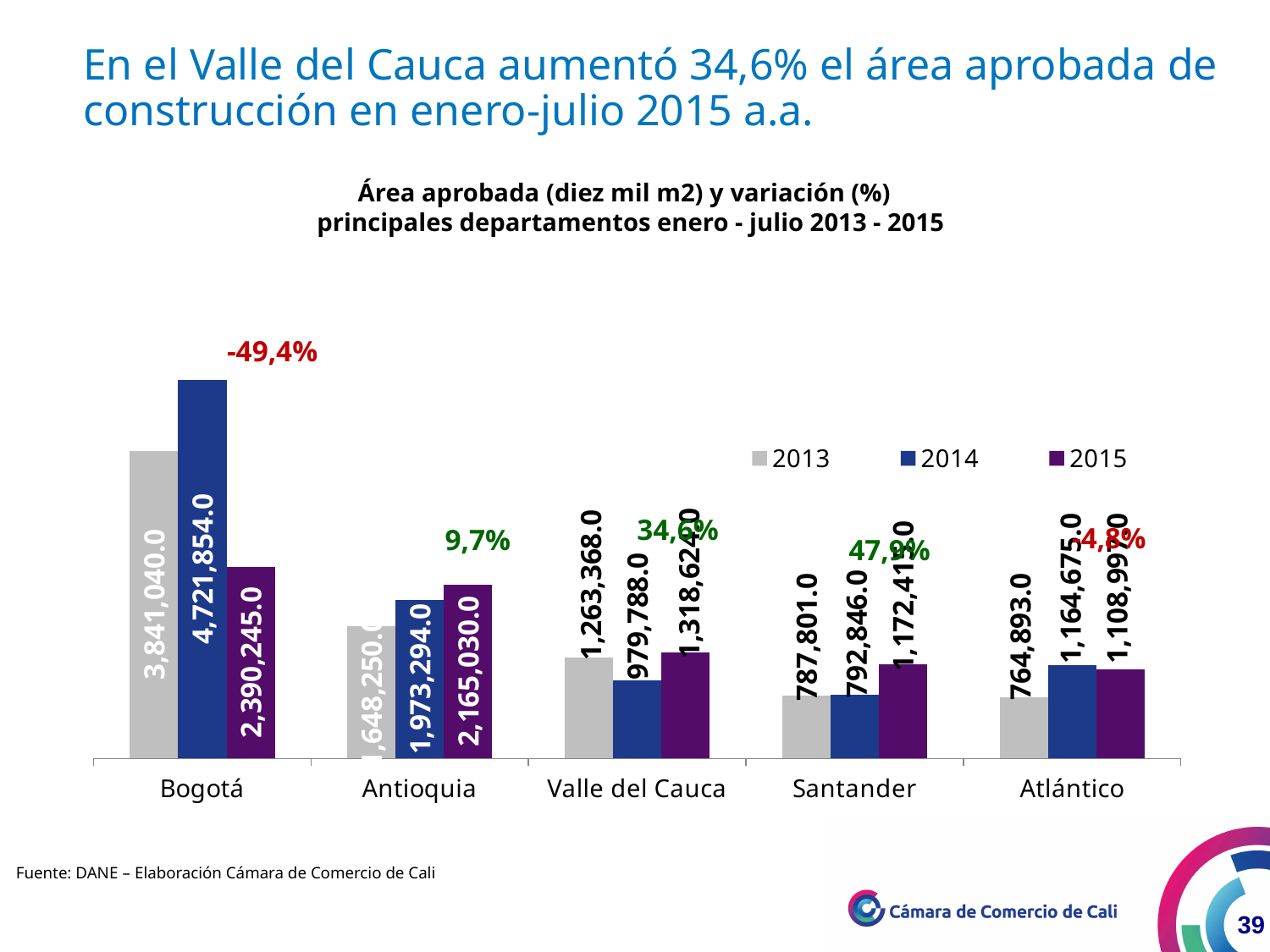
How many series does the legend list? 3 Do the values for Antioquia rise or fall from 2013 to 2015? Rise What is the difference between Bogotá's 2014 value and its 2015 value? 2,331,609.0 What is the difference between Valle del Cauca's 2015 value and its 2014 value? 338,836.0 What is the value for Valle del Cauca in 2015? 1,318,624.0 What is the value for Santander in 2013? 787,801.0 What is the value for Bogotá in 2014? 4,721,854.0 For Valle del Cauca, which year has the larger value, 2013 or 2014? 2013 Which department has the highest value in 2014? Bogotá What kind of chart is shown on the slide? Bar chart How many departments are shown on the x axis? 5 Which department has the lowest value in 2013? Atlántico